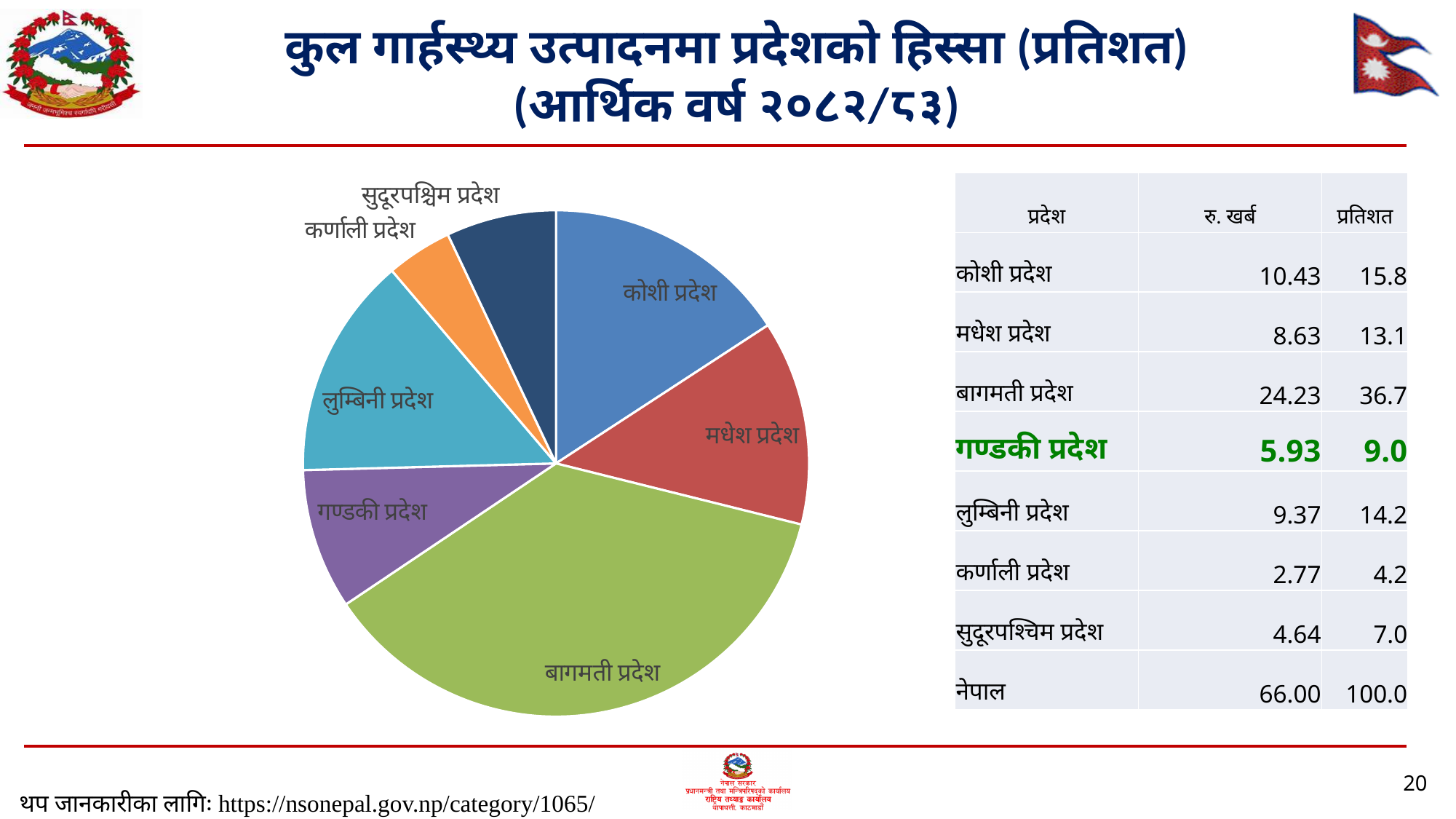
What colour is the slice for कर्णाली प्रदेश in the pie chart? orange According to the table next to the pie chart, what percentage share does बागमती प्रदेश have? 36.7 How many provinces (slices) are shown in the pie chart? 7 According to the table next to the pie chart, what percentage share does गण्डकी प्रदेश have? 9.0 Which slice is larger in the pie chart, कोशी प्रदेश or मधेश प्रदेश? कोशी प्रदेश Which slice is larger in the pie chart, लुम्बिनी प्रदेश or गण्डकी प्रदेश? लुम्बिनी प्रदेश Which province has the largest slice in the pie chart? बागमती प्रदेश Which slice is larger in the pie chart, सुदूरपश्चिम प्रदेश or कर्णाली प्रदेश? सुदूरपश्चिम प्रदेश What kind of chart is shown on the slide? pie chart Which province has the smallest slice in the pie chart? कर्णाली प्रदेश According to the table next to the pie chart, what is the रु. खर्ब value for कोशी प्रदेश? 10.43 What colour is the slice for बागमती प्रदेश in the pie chart? green